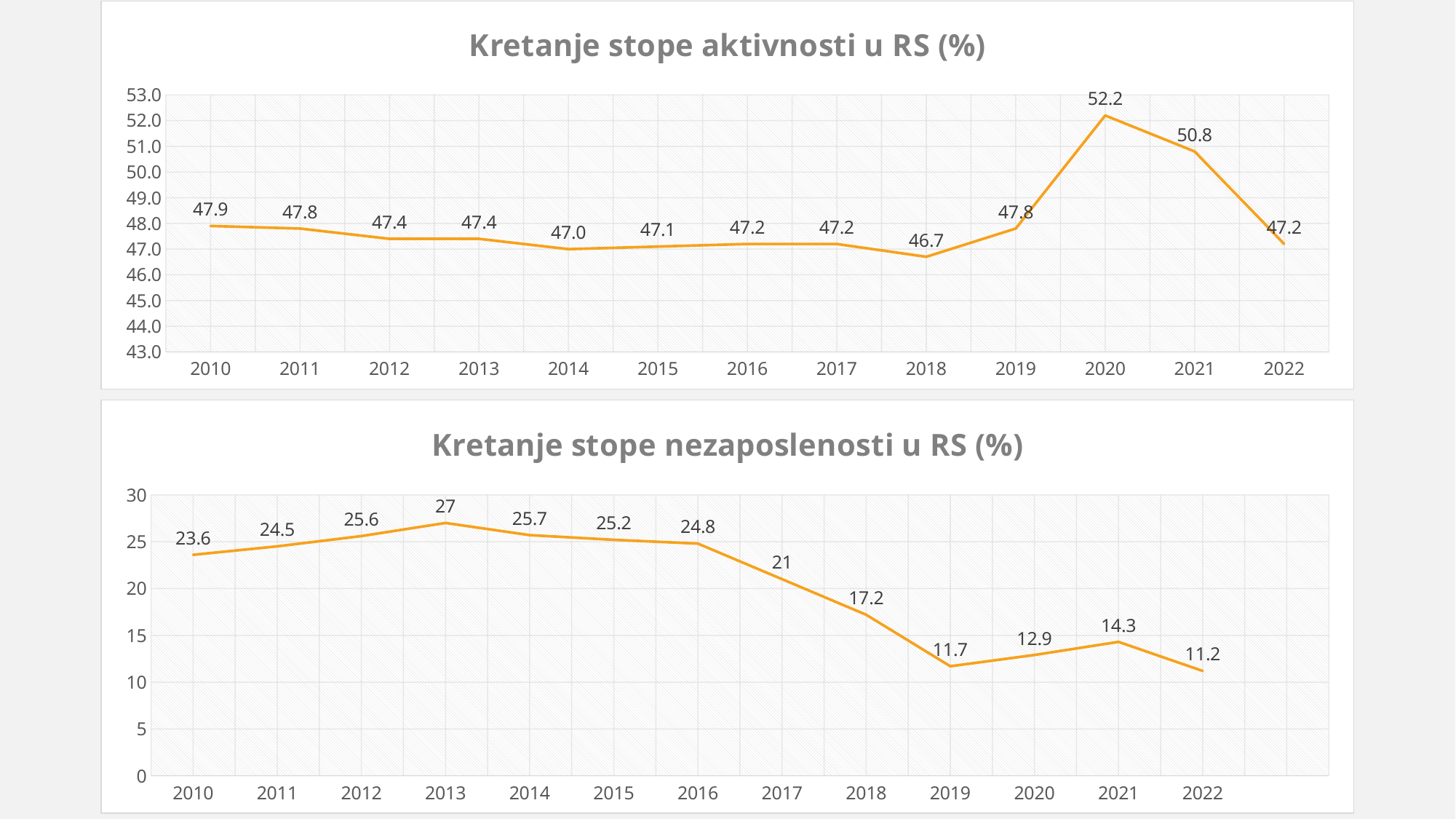
What is the title of the bottom chart on the slide? Kretanje stope nezaposlenosti u RS (%) In the chart 'Kretanje stope aktivnosti u RS (%)', which year has the highest value? 2020 In the chart 'Kretanje stope aktivnosti u RS (%)', how many years are plotted? 13 In the chart 'Kretanje stope aktivnosti u RS (%)', what is the difference between the values for 2020 and 2018? 5.5 What kind of chart is 'Kretanje stope aktivnosti u RS (%)'? Line chart In the chart 'Kretanje stope nezaposlenosti u RS (%)', which year has the lowest value? 2022 In the chart 'Kretanje stope aktivnosti u RS (%)', what is the value for 2020? 52.2 In the chart 'Kretanje stope nezaposlenosti u RS (%)', do the values generally rise or fall from 2013 to 2019? Fall In the chart 'Kretanje stope aktivnosti u RS (%)', which year has the lowest value? 2018 In the chart 'Kretanje stope nezaposlenosti u RS (%)', what is the value for 2013? 27 In the chart 'Kretanje stope nezaposlenosti u RS (%)', which is larger, the value for 2019 or the value for 2021? 2021 In the chart 'Kretanje stope nezaposlenosti u RS (%)', what is the difference between the values for 2010 and 2022? 12.4